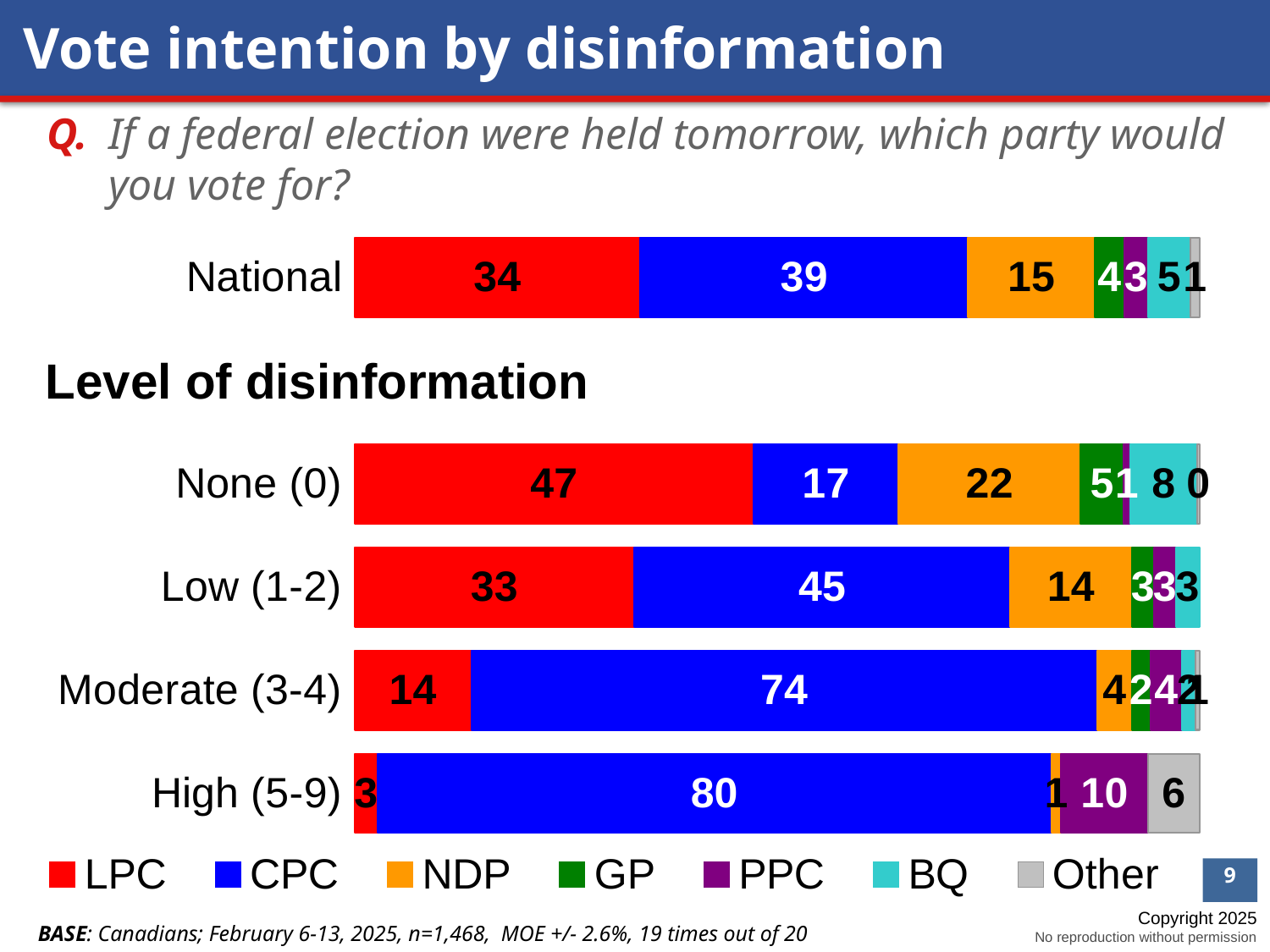
In the Level of disinformation chart, what is the PPC value for High (5-9)? 10 In the National bar at the top of the slide, what is the value for CPC? 39 How many disinformation levels are shown in the Level of disinformation chart? 4 In the Level of disinformation chart, what is the CPC value for High (5-9)? 80 In the Level of disinformation chart, does the LPC value rise or fall as the level of disinformation increases from None (0) to High (5-9)? Fall In the Level of disinformation chart, which level has the lowest LPC value? High (5-9) What kind of chart is used on this slide? Bar chart In the Level of disinformation chart, which level has the highest CPC value? High (5-9) In the Level of disinformation chart, what is the difference between the CPC value for High (5-9) and the CPC value for None (0)? 63 In the Level of disinformation chart, for Low (1-2), which is larger: LPC or CPC? CPC In the Level of disinformation chart, what is the LPC value for None (0)? 47 How many parties does the legend at the bottom of the slide list? 7